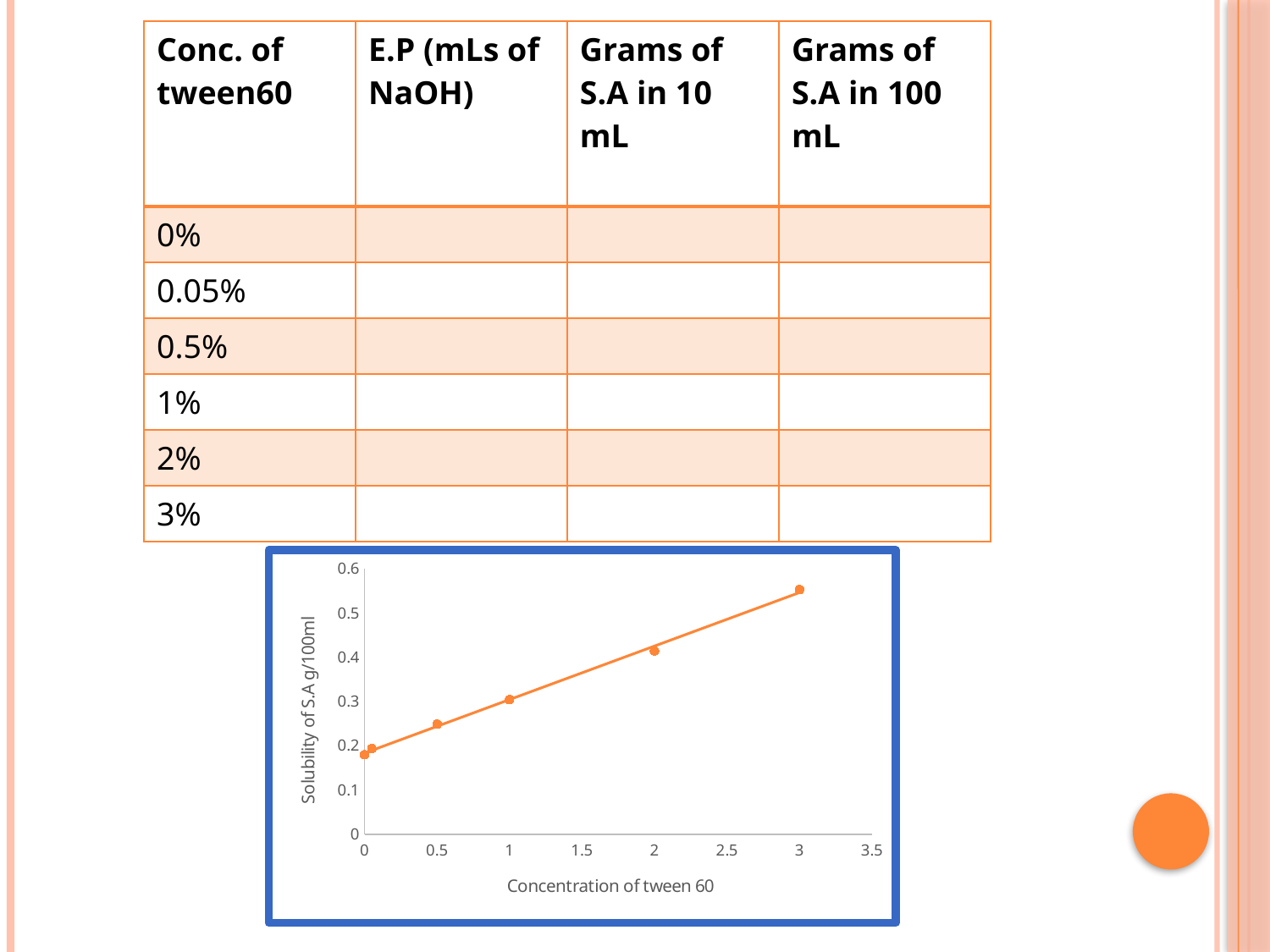
What kind of chart is shown on the slide? Scatter chart with a trend line At which concentration of tween 60 is the plotted solubility highest? 3 Is the solubility value at a concentration of 0 greater or less than 0.2? less What is the title of the y axis of the chart? Solubility of S.A g/100ml Is the solubility value at a concentration of 3 greater or less than 0.5? greater At which concentration of tween 60 is the plotted solubility lowest? 0 Which has the larger solubility value, the point at concentration 1 or the point at concentration 2? Concentration 2 Is the solubility value at a concentration of 1 greater or less than 0.4? less What is the title of the x axis of the chart? Concentration of tween 60 Do the plotted solubility values rise or fall as the concentration of tween 60 increases? Rise